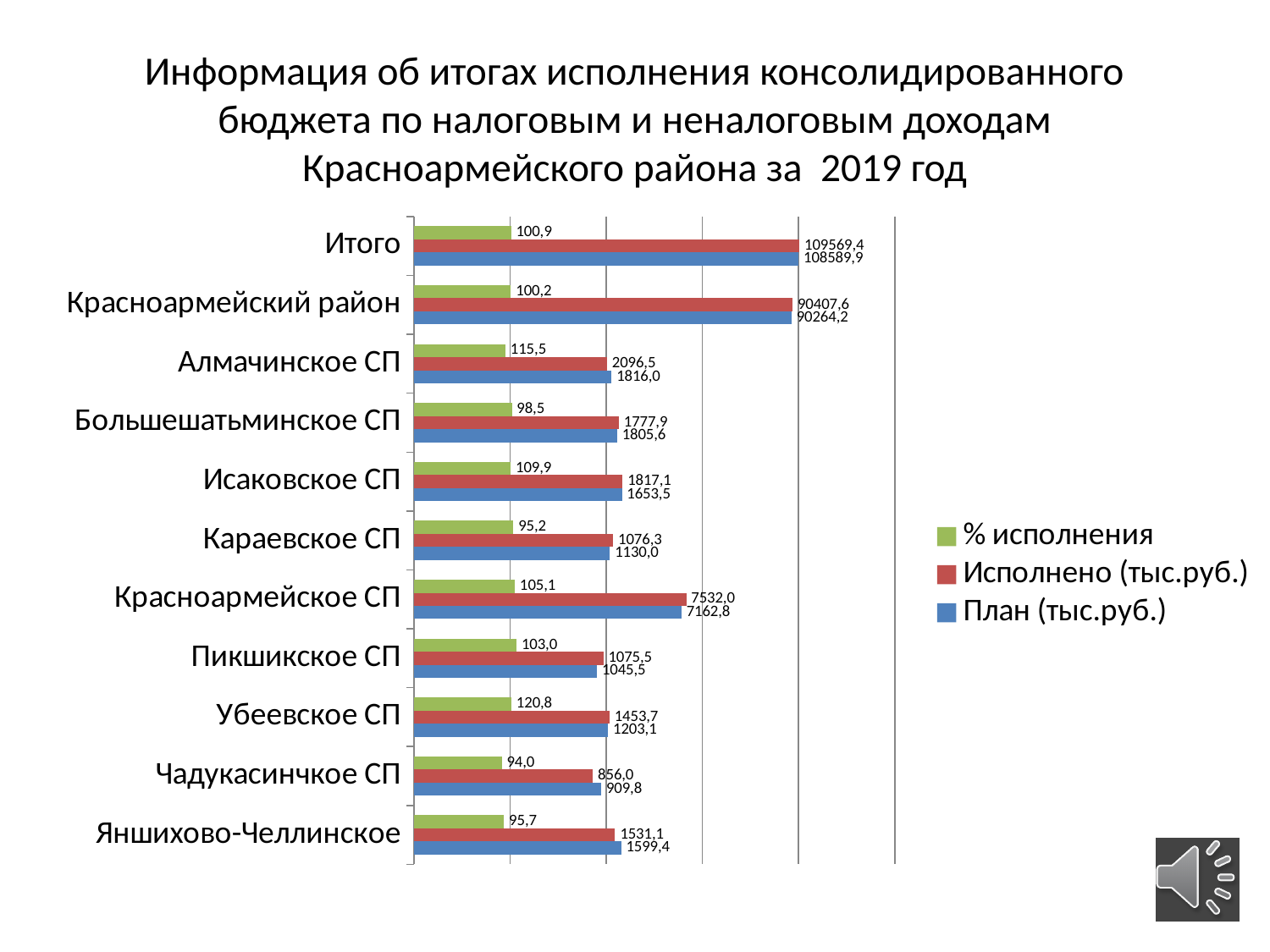
What is the value of Исполнено (тыс.руб.) for Убеевское СП? 1453,7 Which is larger for Красноармейское СП: Исполнено (тыс.руб.) or План (тыс.руб.)? Исполнено (тыс.руб.) What is the % исполнения value for Алмачинское СП? 115,5 How many series does the legend list? 3 Which category has the lowest % исполнения value? Чадукасинчкое СП Which category has the highest % исполнения value? Убеевское СП What is the value of Исполнено (тыс.руб.) for Итого? 109569,4 Which category has the lowest Исполнено (тыс.руб.) value? Чадукасинчкое СП What is the difference between Исполнено (тыс.руб.) and План (тыс.руб.) for Убеевское СП? 250,6 What kind of chart is shown on the slide? Bar chart What is the value of План (тыс.руб.) for Караевское СП? 1130,0 How many categories are shown on the chart? 11